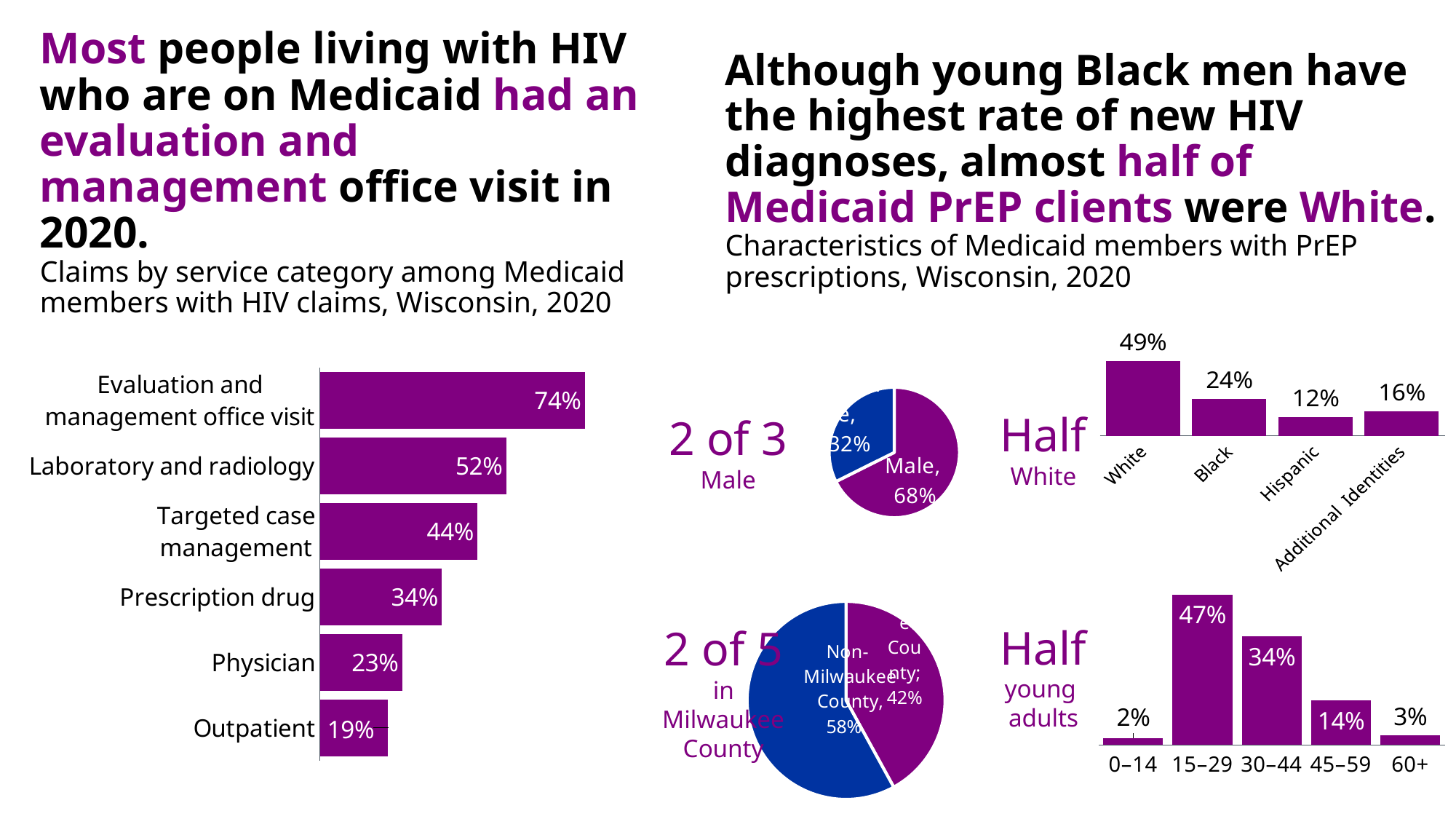
In the left bar chart of claims by service category, what is the difference between the Evaluation and management office visit value and the Prescription drug value? 40% In the race/ethnicity bar chart on the right, which is larger: Hispanic or Additional Identities? Additional Identities In the left bar chart of claims by service category among Medicaid members with HIV claims, what percentage is shown for Laboratory and radiology? 52% How many service categories are shown in the left bar chart of claims by service category? 6 In the race/ethnicity bar chart on the right (White, Black, Hispanic, Additional Identities), what percentage is shown for Black? 24% What kind of chart is used on the left to show claims by service category? Bar chart In the left bar chart of claims by service category, which service category has the lowest percentage? Outpatient In the age group bar chart at the bottom right, what percentage is shown for the 30–44 age group? 34% In the pie chart about sex at the top centre, what share is labelled Male? 68% In the pie chart about Milwaukee County at the bottom centre, what share is labelled Non-Milwaukee County? 58% In the race/ethnicity bar chart on the right, which category has the highest percentage? White In the age group bar chart at the bottom right, which age group has the highest percentage? 15–29